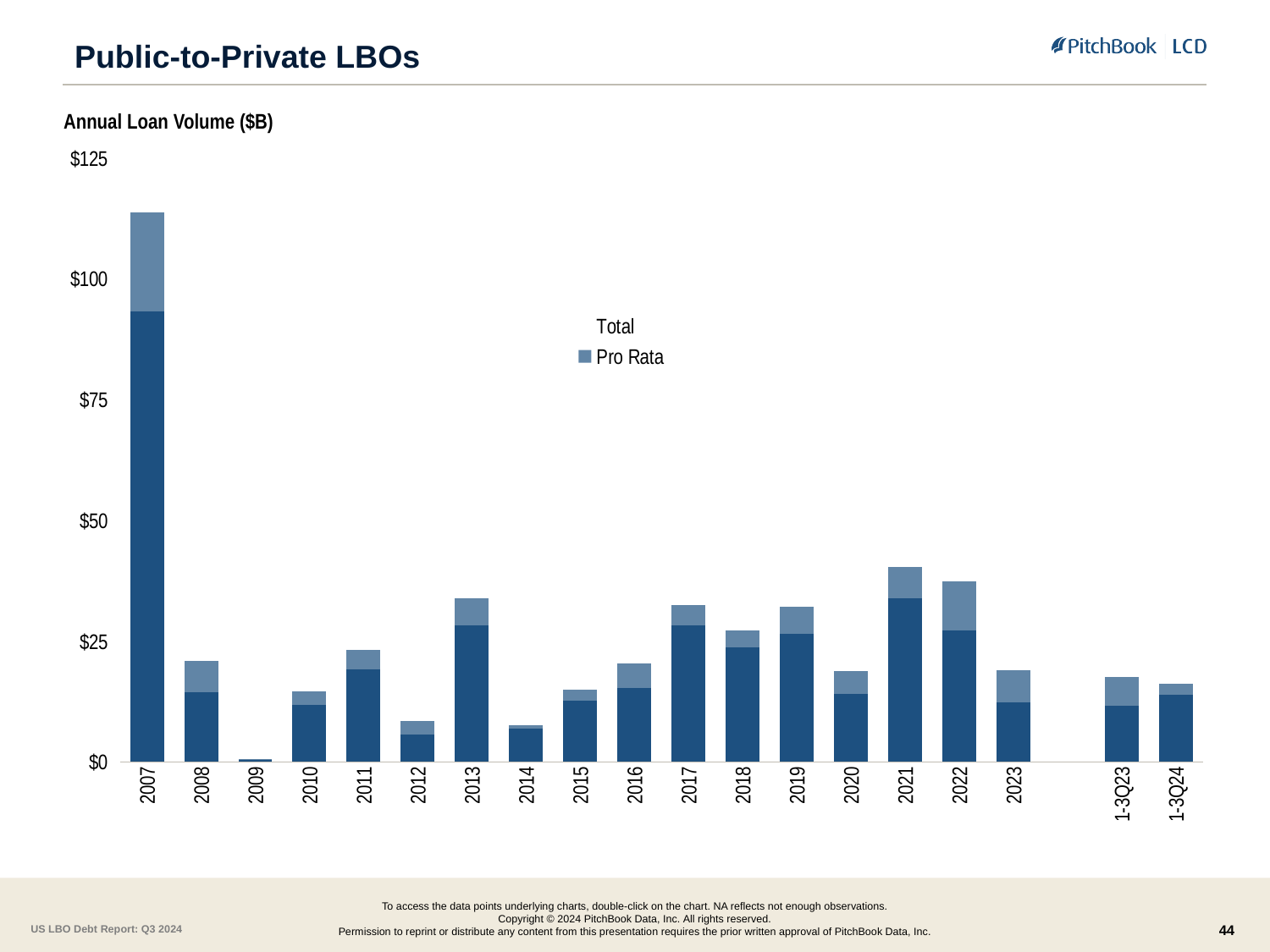
Which year has the highest total annual loan volume? 2007 How many series does the legend list? 2 Do the total values rise or fall from 2014 to 2017? Rise How many categories are shown along the x axis? 19 What are the two entries listed in the legend? Total and Pro Rata What kind of chart is shown on the slide? Stacked bar chart Is the total value for 2014 greater or less than $25? less Is the total value for 2007 greater or less than $100? greater Is the total value for 2021 greater or less than $25? greater Which year has the lowest total annual loan volume? 2009 Which has the larger total annual loan volume, 2020 or 2021? 2021